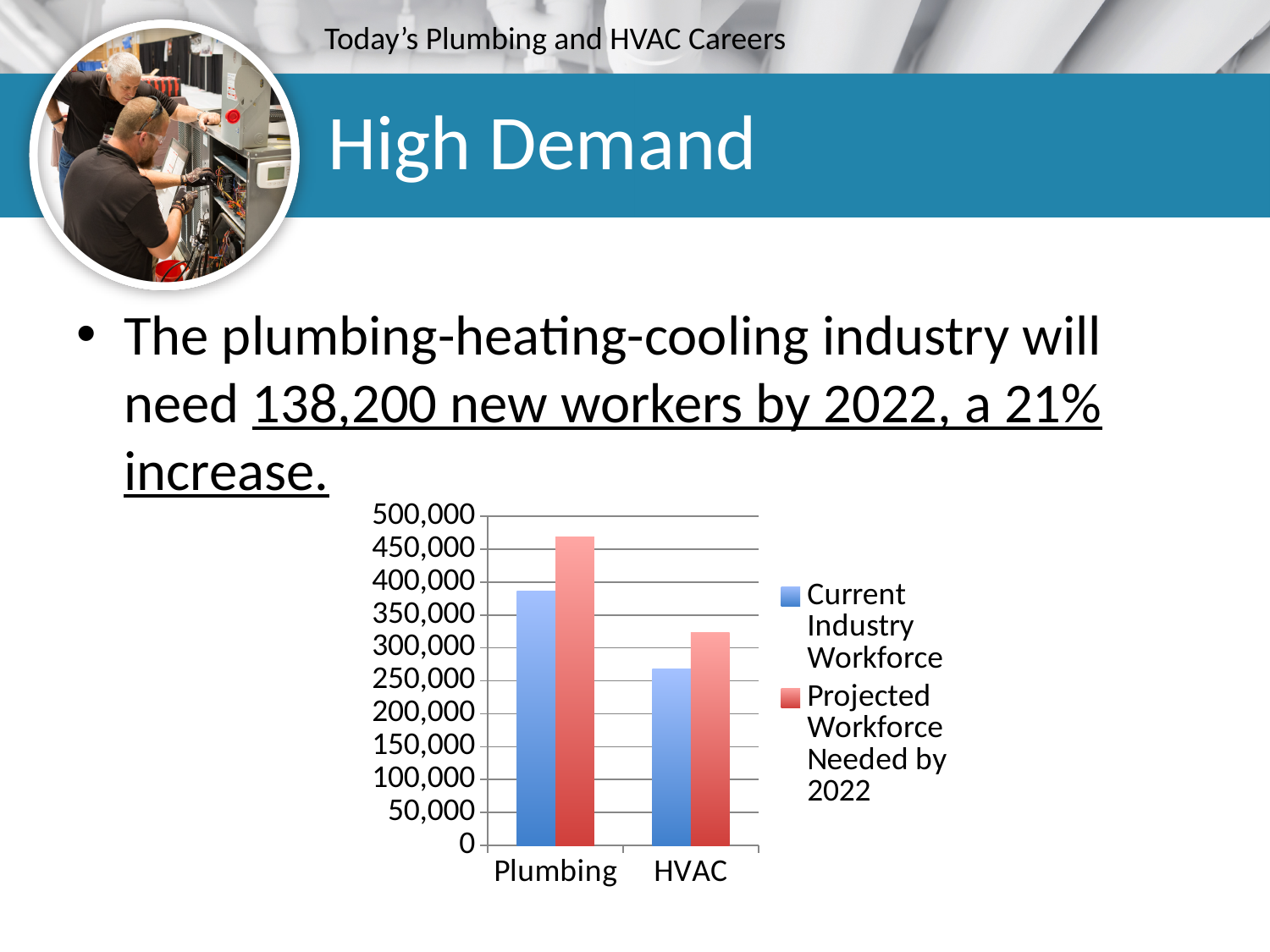
What kind of chart is shown on the slide? bar chart Which category has the lowest Current Industry Workforce? HVAC Which is larger: the Current Industry Workforce for Plumbing or the Projected Workforce Needed by 2022 for HVAC? Current Industry Workforce for Plumbing How many categories are shown on the x axis of the chart? 2 Is the Current Industry Workforce for Plumbing greater or less than 350,000? greater What colour are the bars for the Projected Workforce Needed by 2022 series? red Which category has the highest Projected Workforce Needed by 2022? Plumbing Is the Current Industry Workforce for HVAC greater or less than 300,000? less For HVAC, which is larger: the Current Industry Workforce or the Projected Workforce Needed by 2022? Projected Workforce Needed by 2022 How many series does the chart's legend list? 2 Is the Projected Workforce Needed by 2022 for Plumbing greater or less than 450,000? greater